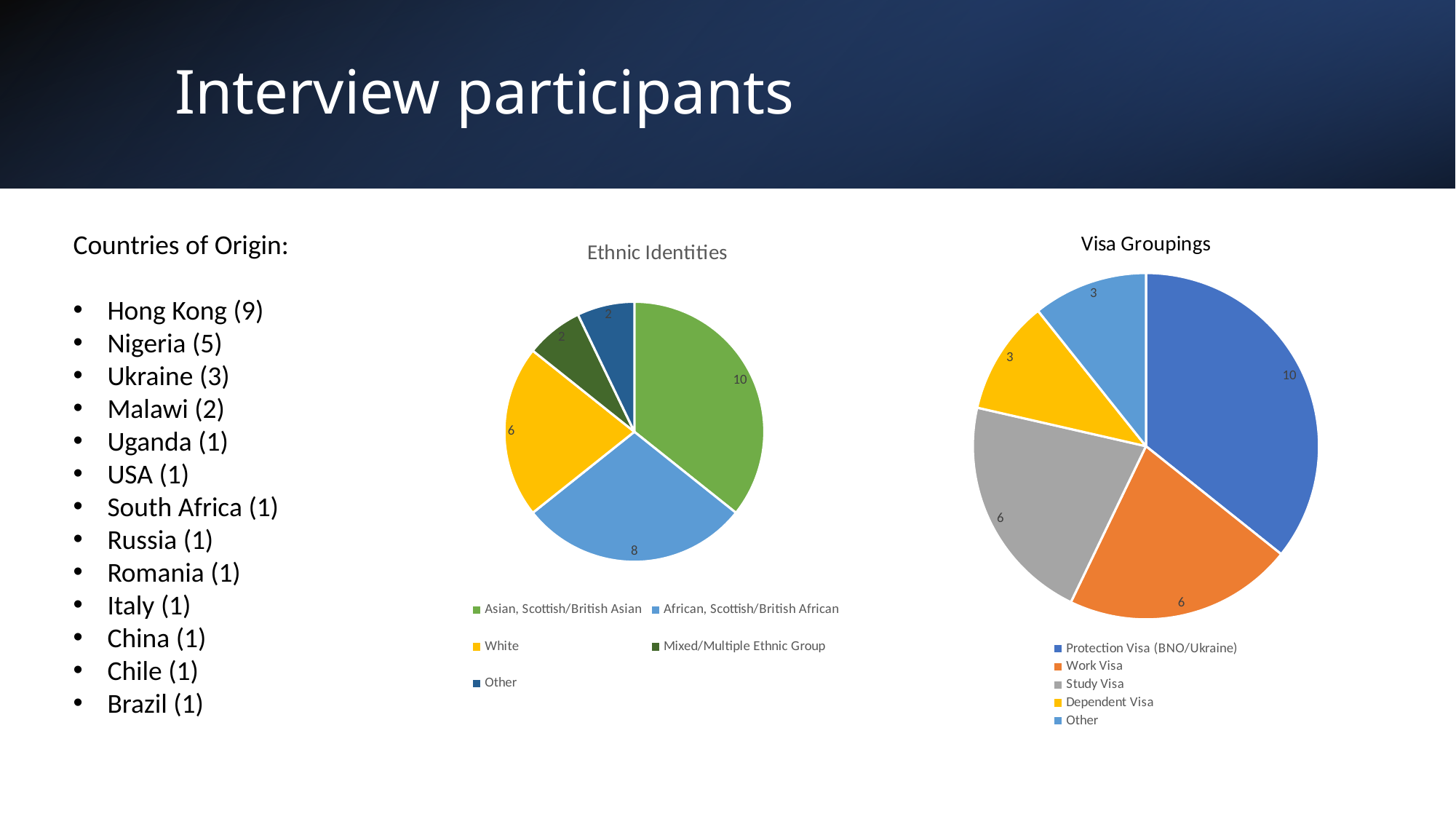
How many categories does the legend of the Visa Groupings chart list? 5 In the Visa Groupings chart, which is larger: Work Visa or Other? Work Visa In the Ethnic Identities chart, which category has the largest slice? Asian, Scottish/British Asian In the Ethnic Identities chart, what is the value for African, Scottish/British African? 8 In the Ethnic Identities chart, what is the difference between the Asian, Scottish/British Asian and White values? 4 How many slices does the Ethnic Identities pie chart have? 5 In the Ethnic Identities chart, what is the value for White? 6 In the Visa Groupings chart, what is the difference between the Protection Visa (BNO/Ukraine) and Study Visa values? 4 In the Visa Groupings chart, which category has the largest slice? Protection Visa (BNO/Ukraine) What type of chart is the Ethnic Identities chart? Pie chart In the Visa Groupings chart, what is the value for Dependent Visa? 3 In the Visa Groupings chart, what is the value for Protection Visa (BNO/Ukraine)? 10